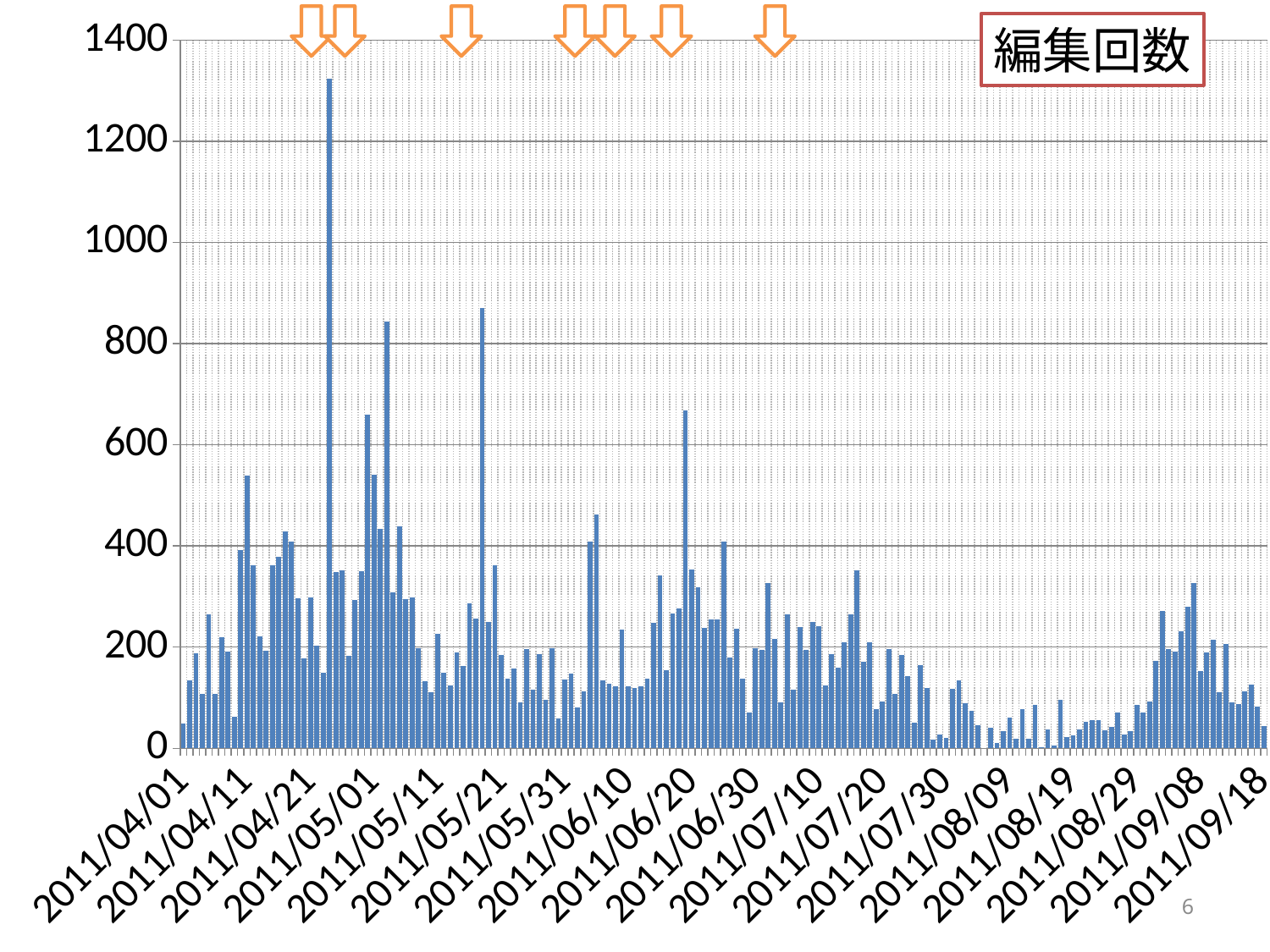
What is the last date label on the x axis? 2011/09/18 What kind of chart is shown on the slide? bar chart What is the highest value shown on the y axis? 1400 How many date labels are printed along the x axis? 18 Is the tallest bar in the chart greater or less than 1200? greater How many bars in the chart exceed 800? 3 How many orange arrows are placed above the chart? 7 Is the value for 2011/04/01 greater or less than 200? less What is the first date label on the x axis? 2011/04/01 What is the title shown in the box at the top right of the chart? 編集回数 Are the values in early August generally higher or lower than the values in April? lower